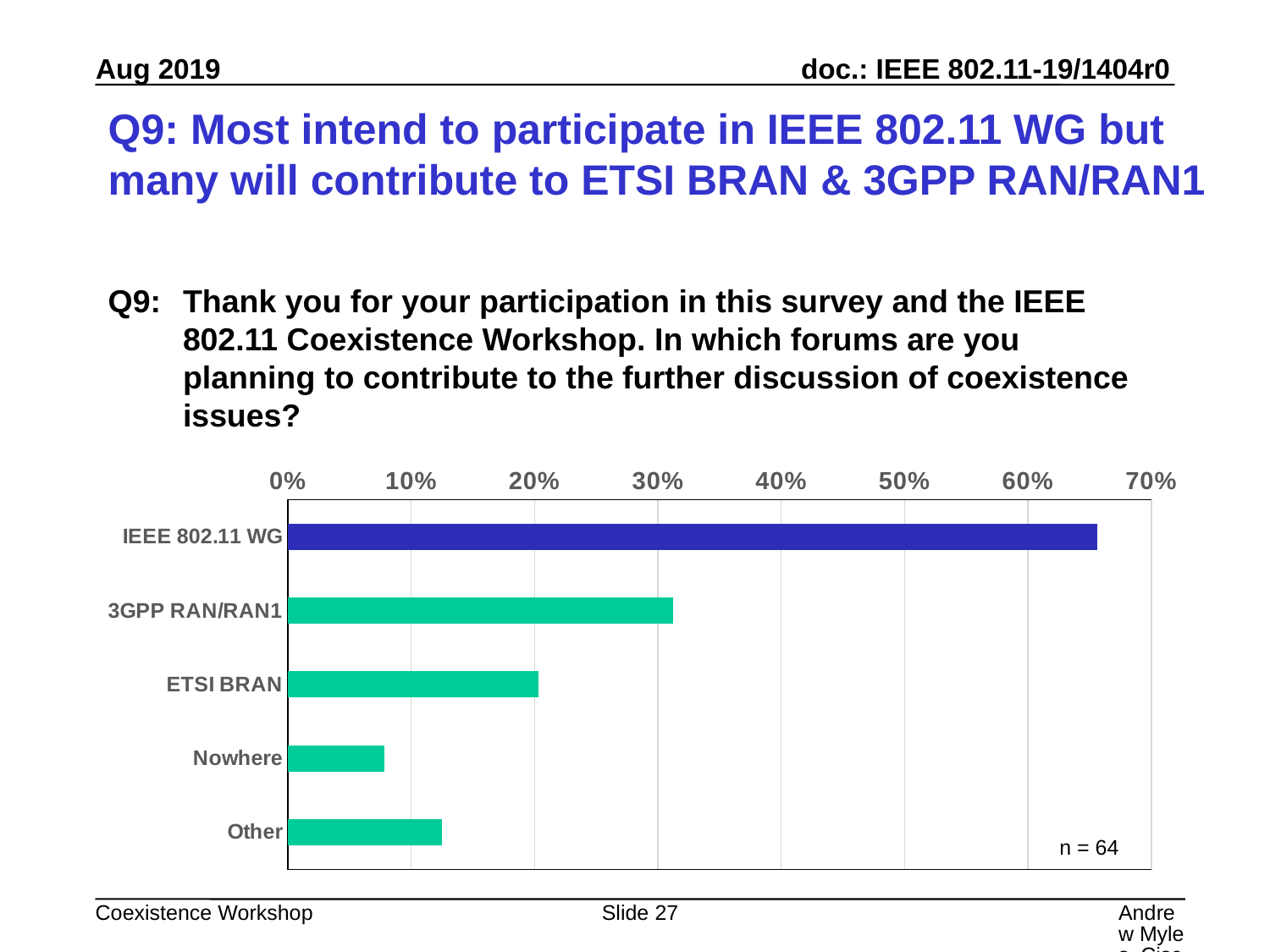
Is the value for Other greater or less than 20%? less Which forum has the highest value in the chart? IEEE 802.11 WG Is the value for ETSI BRAN greater or less than 30%? less Is the value for Nowhere greater or less than 10%? less How many categories (forums) are shown in the chart? 5 Which has a larger value, Other or Nowhere? Other What sample size (n) is noted on the chart? n = 64 Which has a larger value, 3GPP RAN/RAN1 or ETSI BRAN? 3GPP RAN/RAN1 What kind of chart is shown on the slide? bar chart Which forum has the lowest value in the chart? Nowhere